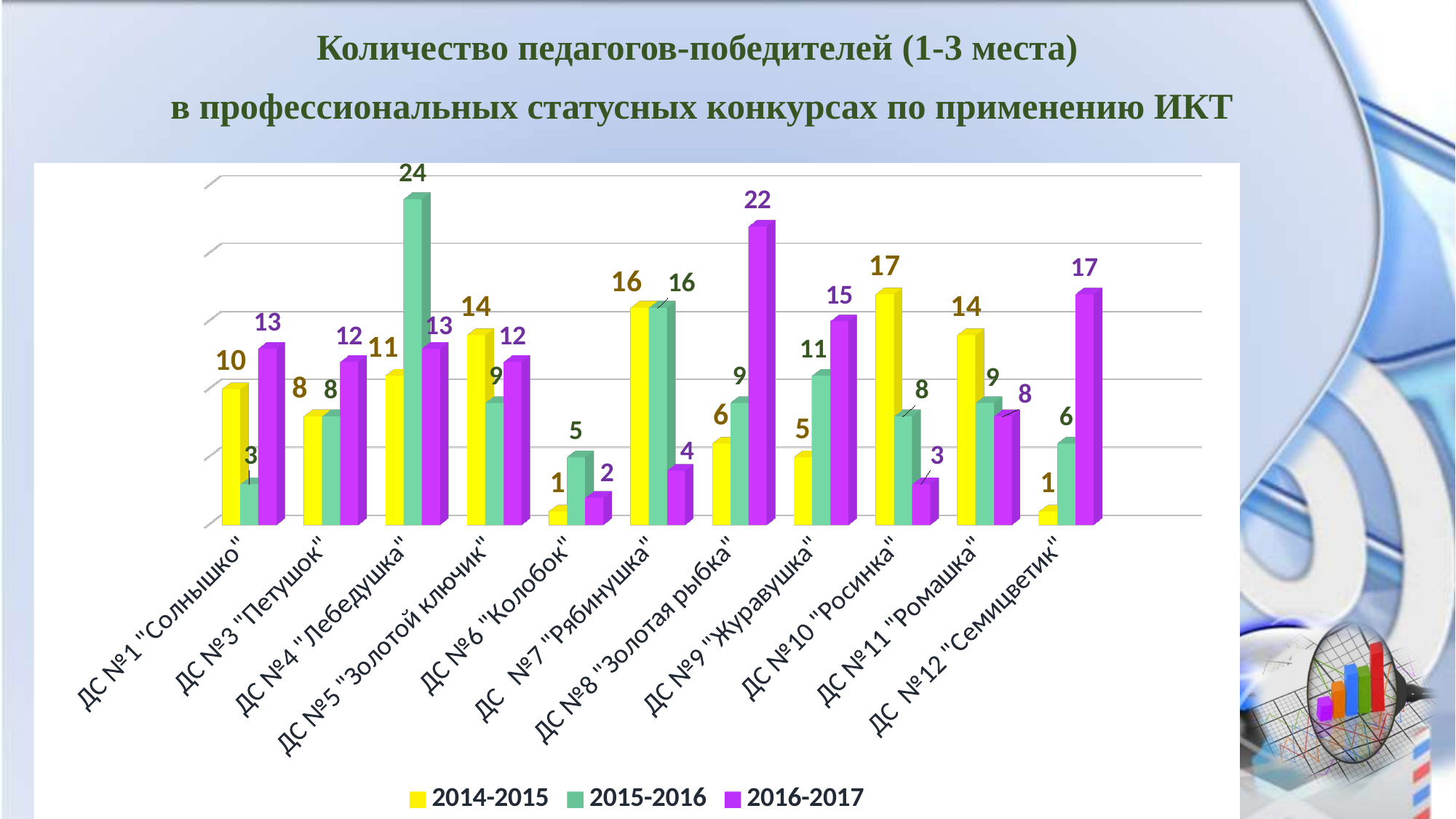
Which kindergarten has the highest value in the 2016-2017 series? ДС №8 "Золотая рыбка" Which kindergarten has the lowest value in the 2015-2016 series? ДС №1 "Солнышко" How many kindergartens (categories) are shown on the x axis? 11 What is the difference between the 2016-2017 and 2014-2015 values for ДС №12 "Семицветик"? 16 How many series does the legend list? 3 What is the value for ДС №8 "Золотая рыбка" in 2016-2017? 22 Which kindergarten has the lowest value in the 2016-2017 series? ДС №6 "Колобок" Which series is shown in purple in the legend? 2016-2017 What is the value for ДС №10 "Росинка" in 2014-2015? 17 What type of chart is shown on the slide? bar chart What is the value for ДС №4 "Лебедушка" in 2015-2016? 24 Which is larger for ДС №9 "Журавушка": the 2014-2015 value or the 2016-2017 value? 2016-2017